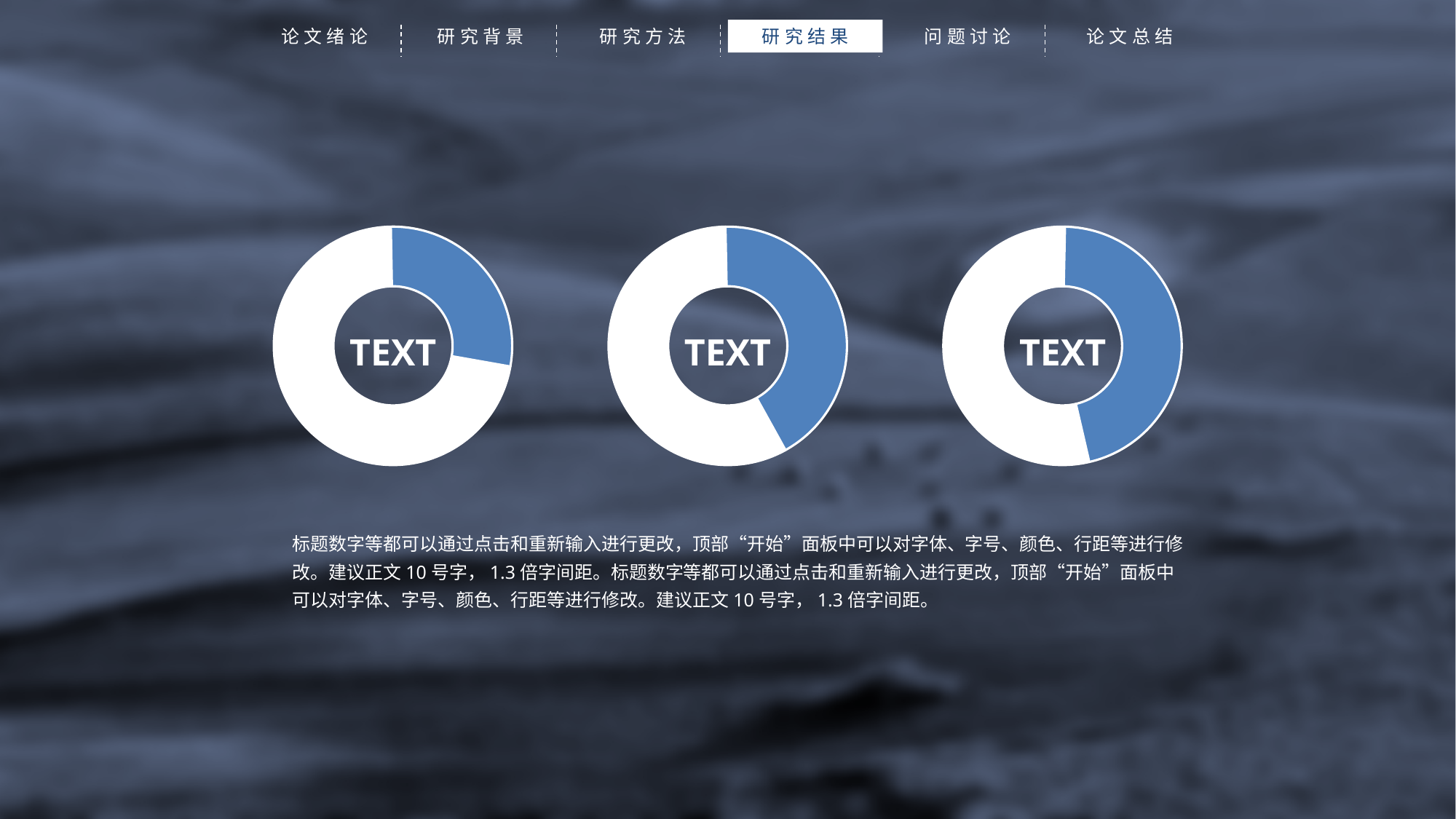
What text is printed in the centre of each donut chart? TEXT Is the blue slice in the left donut chart more or less than half of the ring? less In the left donut chart, is the blue slice larger or smaller than the white slice? smaller Which chart has the larger blue slice, the left donut chart or the right donut chart? the right donut chart What kind of chart is the left chart on the slide? donut chart In the middle donut chart, is the blue slice larger or smaller than the white slice? smaller How many donut charts are shown on the slide? 3 How many slices does the left donut chart have? 2 What two colours are used for the slices of the donut charts? blue and white